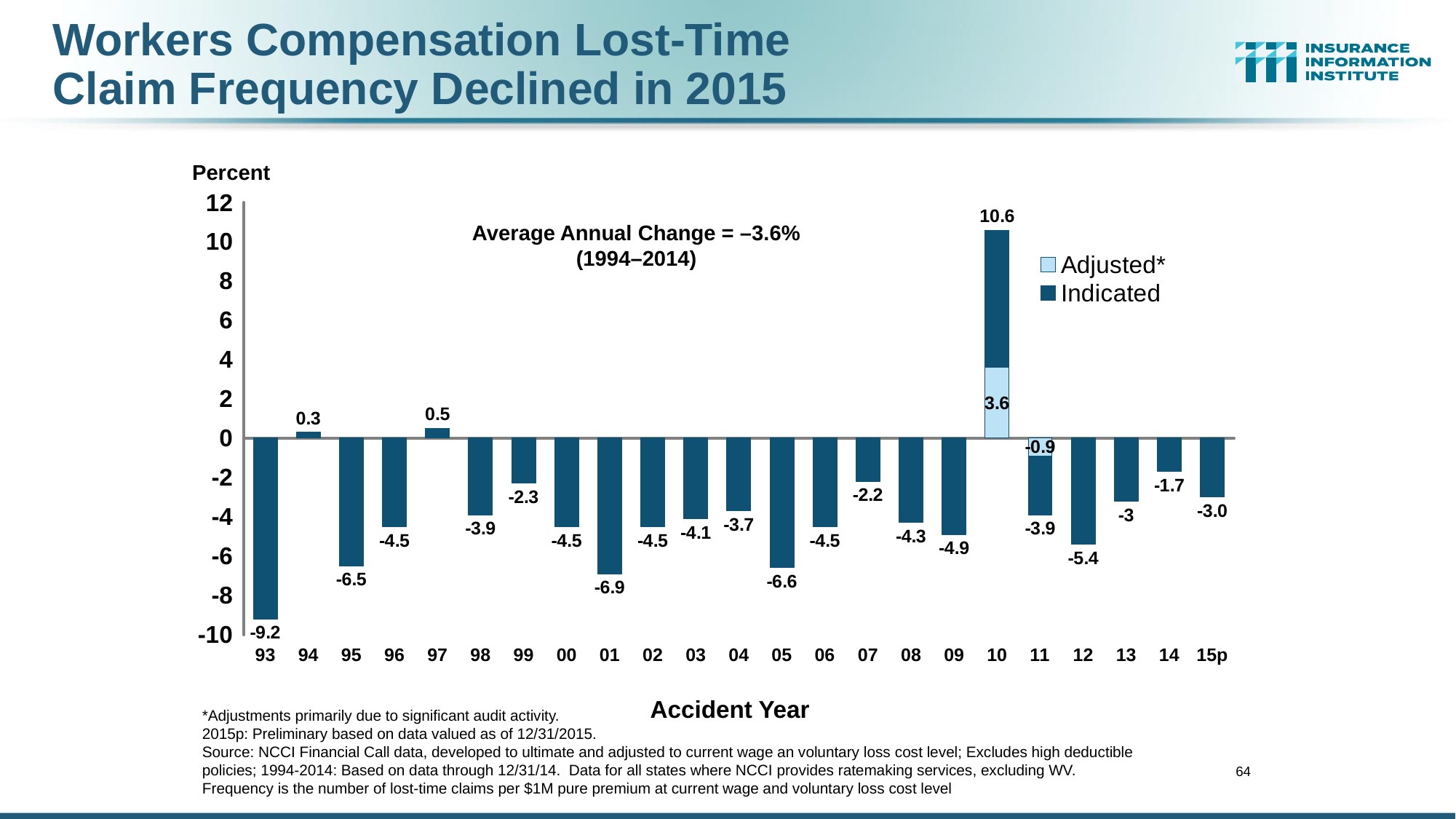
How many series does the legend list? 2 What is the value for accident year 15p? -3.0 Which is larger, the value for accident year 94 or accident year 97? 97 What kind of chart is shown on the slide? bar chart What is the value for accident year 93? -9.2 What average annual change for 1994–2014 is stated on the chart? –3.6% What is the difference between the values for accident years 01 and 05? 0.3 What is the Indicated value for accident year 10? 10.6 Which accident year has the lowest value? 93 How many accident years are shown on the x axis? 23 What is the Adjusted value for accident year 10? 3.6 Which accident year has the highest value? 10